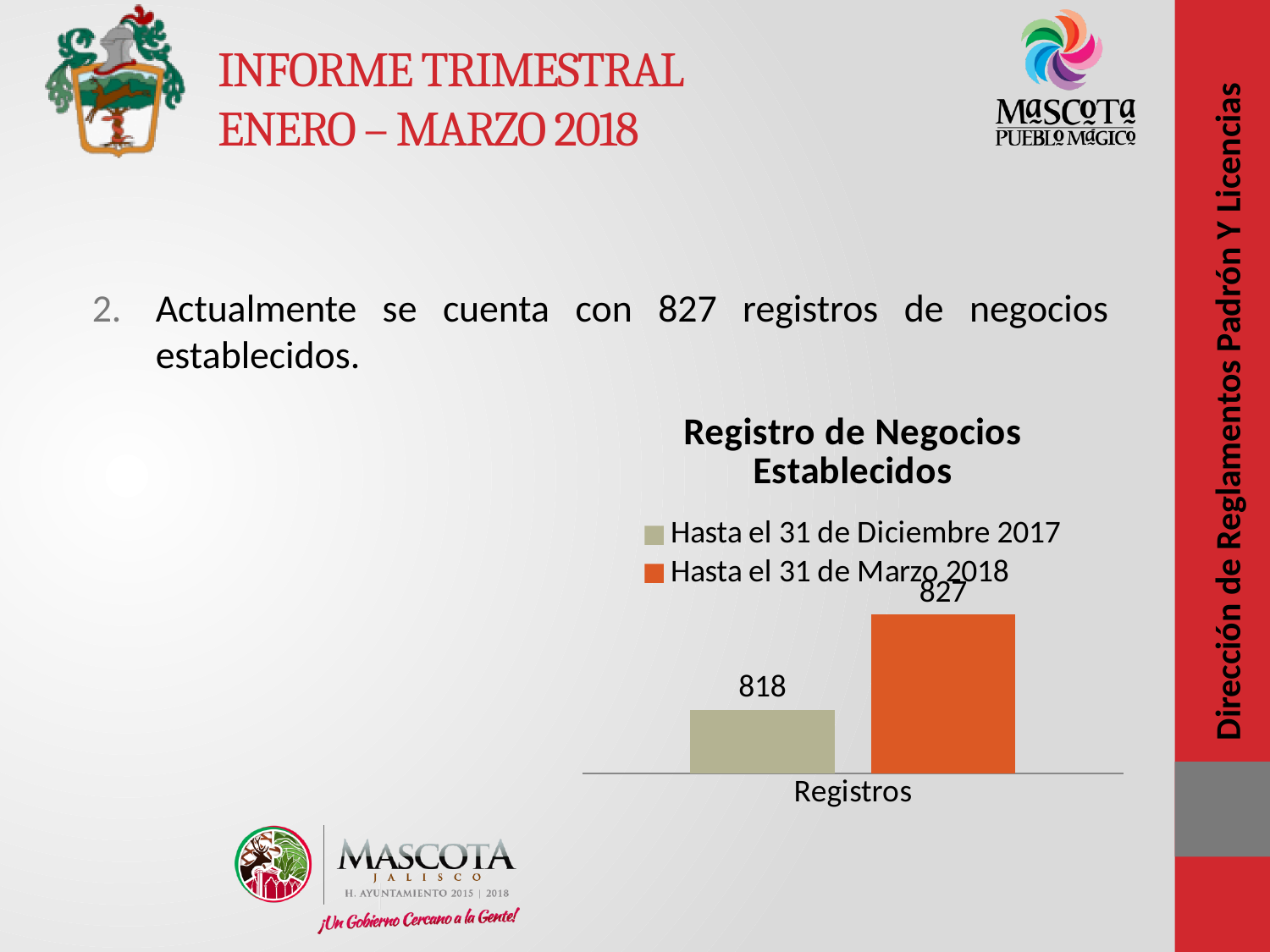
Which series has the lower value in the Registro de Negocios Establecidos chart? Hasta el 31 de Diciembre 2017 What is the title of the chart on the slide? Registro de Negocios Establecidos How many series does the legend of the chart list? 2 Which series has the higher value in the Registro de Negocios Establecidos chart? Hasta el 31 de Marzo 2018 What is the category label on the x axis of the chart? Registros What kind of chart is shown on the slide? bar chart How many categories are shown on the x axis of the chart? 1 What is the value for 'Hasta el 31 de Diciembre 2017' in the Registro de Negocios Establecidos chart? 818 What is the difference between the 'Hasta el 31 de Marzo 2018' and 'Hasta el 31 de Diciembre 2017' values? 9 Is the value for 'Hasta el 31 de Marzo 2018' larger or smaller than the value for 'Hasta el 31 de Diciembre 2017'? larger What is the value for 'Hasta el 31 de Marzo 2018' in the Registro de Negocios Establecidos chart? 827 Did the number of registros rise or fall from 31 de Diciembre 2017 to 31 de Marzo 2018? rise